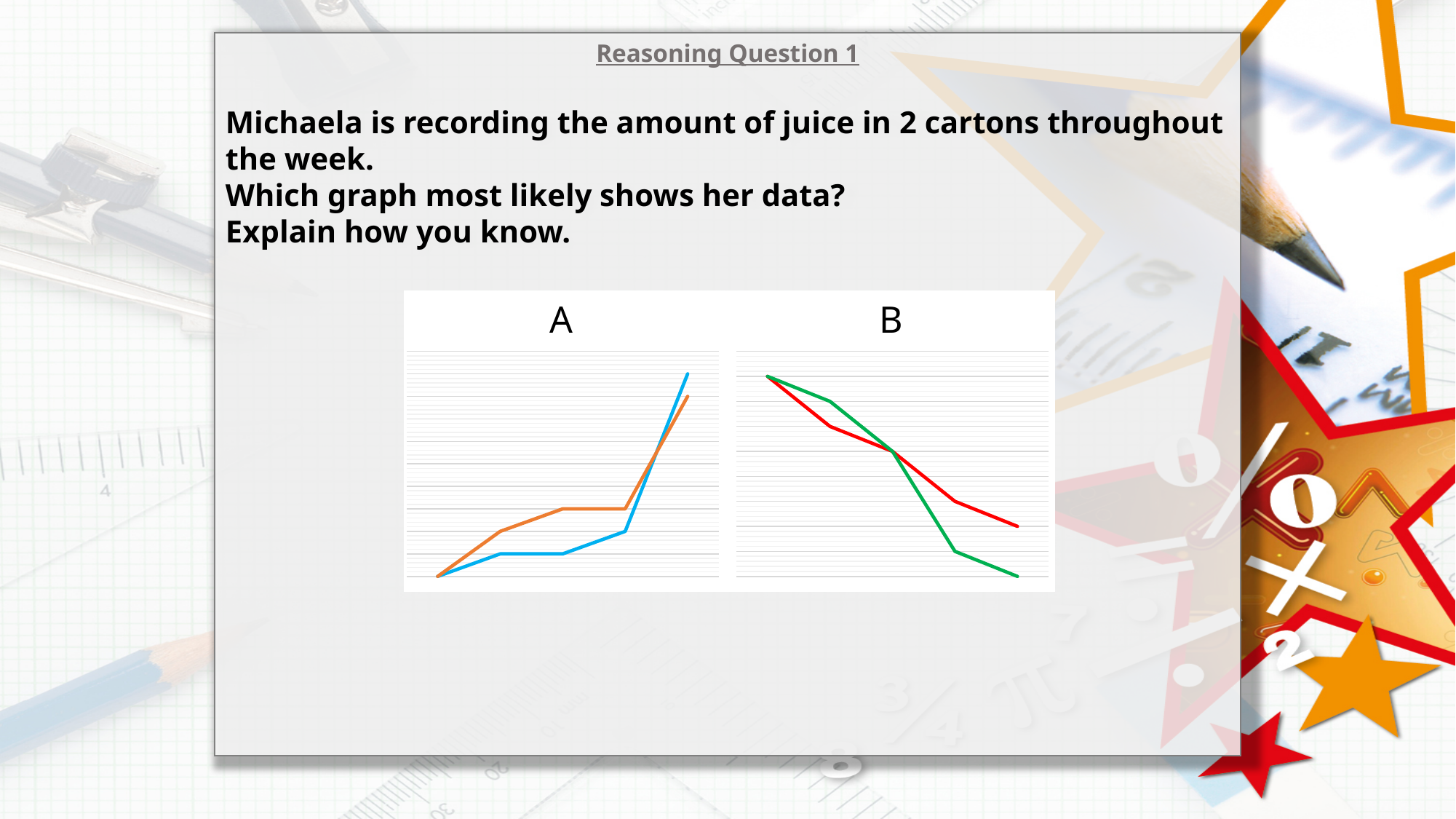
Which chart, A or B, shows the values increasing over time? A How many lines are plotted in chart A? 2 In chart A, which line ends higher at the right-hand side, the blue line or the orange line? blue What colours are the two lines in chart A? blue and orange What kind of chart is chart B? line chart How many lines are plotted in chart B? 2 What colours are the two lines in chart B? green and red What kind of chart is chart A? line chart Which chart, A or B, shows the values decreasing over time? B In chart A, do the lines rise or fall from left to right? rise In chart B, which line ends lower at the right-hand side, the green line or the red line? green